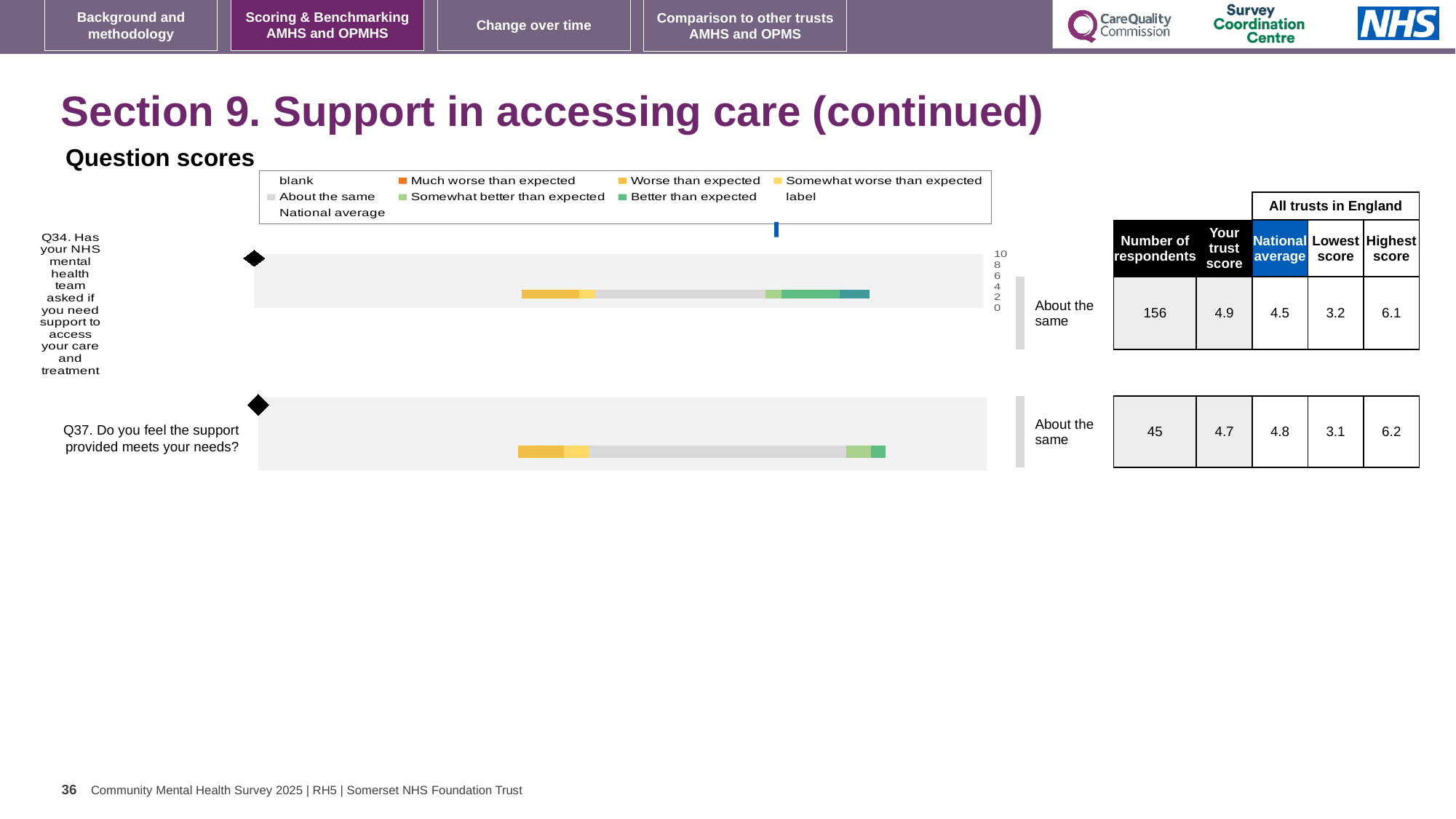
What category label is shown next to the bar for Q37? About the same What is the highest score among all trusts in England for Q34? 6.1 What is the trust score for Q34 shown in the table beside the chart? 4.9 What is the national average score for Q37? 4.8 What colour in the legend represents 'Better than expected'? green What is the difference between the trust scores for Q34 and Q37? 0.2 What is the trust score for Q37 shown in the table beside the chart? 4.7 Which question has the higher trust score, Q34 or Q37? Q34 What kind of chart is used to show the question scores on this slide? bar chart How many respondents answered Q34? 156 How many questions are plotted in the question scores chart? 2 What category label is shown next to the bar for Q34? About the same